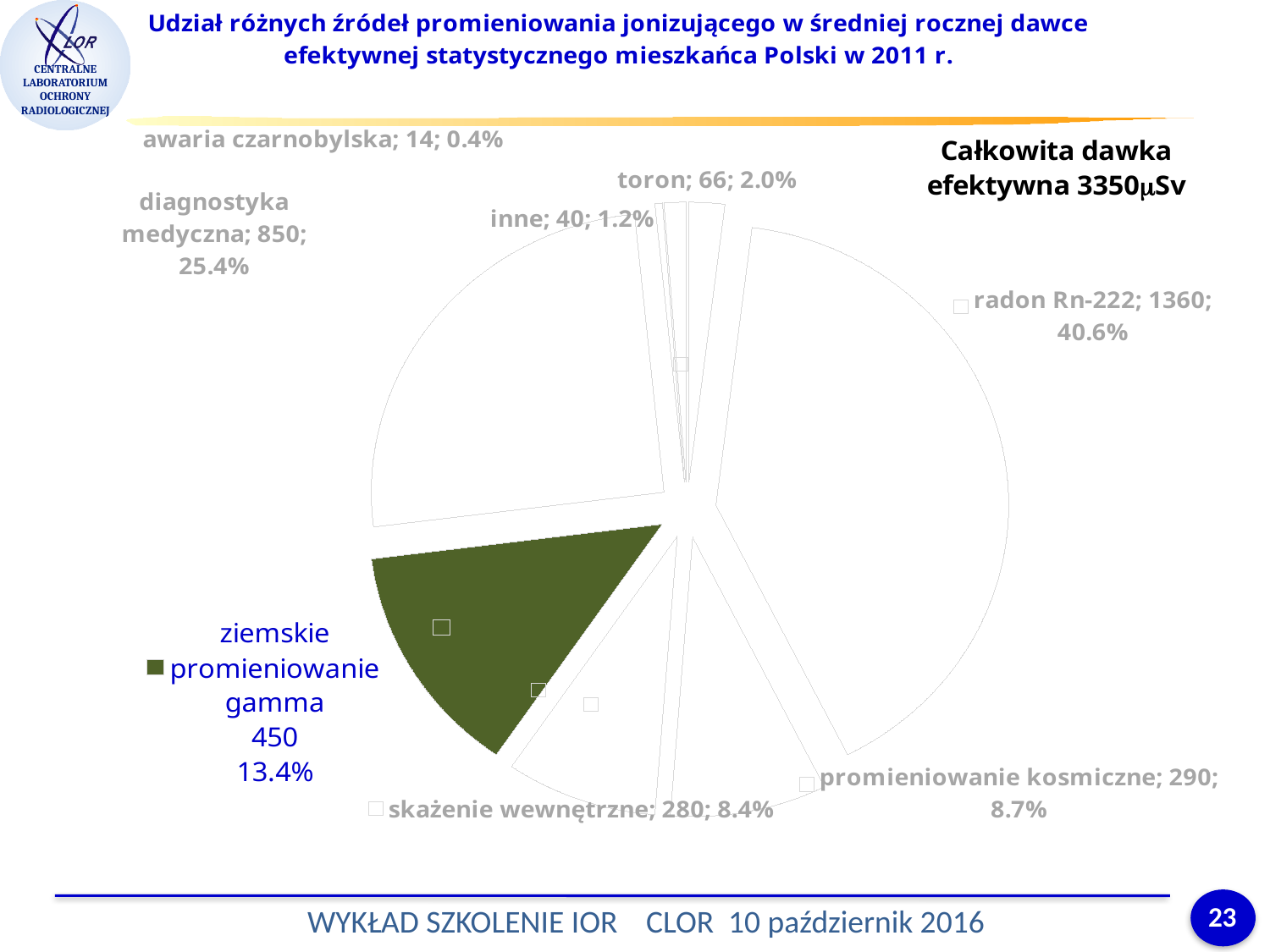
Which category has the largest share of the pie? radon Rn-222 What value is shown for radon Rn-222? 1360 How many categories (slices) does the pie chart show? 8 What value is shown for ziemskie promieniowanie gamma? 450 What total effective dose is stated on the slide? 3350 µSv Which category has the smallest share of the pie? awaria czarnobylska What kind of chart is shown on the slide? pie chart Which is larger, the value for toron or the value for inne? toron Which slice of the pie is filled with a dark green colour? ziemskie promieniowanie gamma What percentage share is shown for skażenie wewnętrzne? 8.4% What percentage share is shown for diagnostyka medyczna? 25.4% What is the difference between the values for promieniowanie kosmiczne and skażenie wewnętrzne? 10